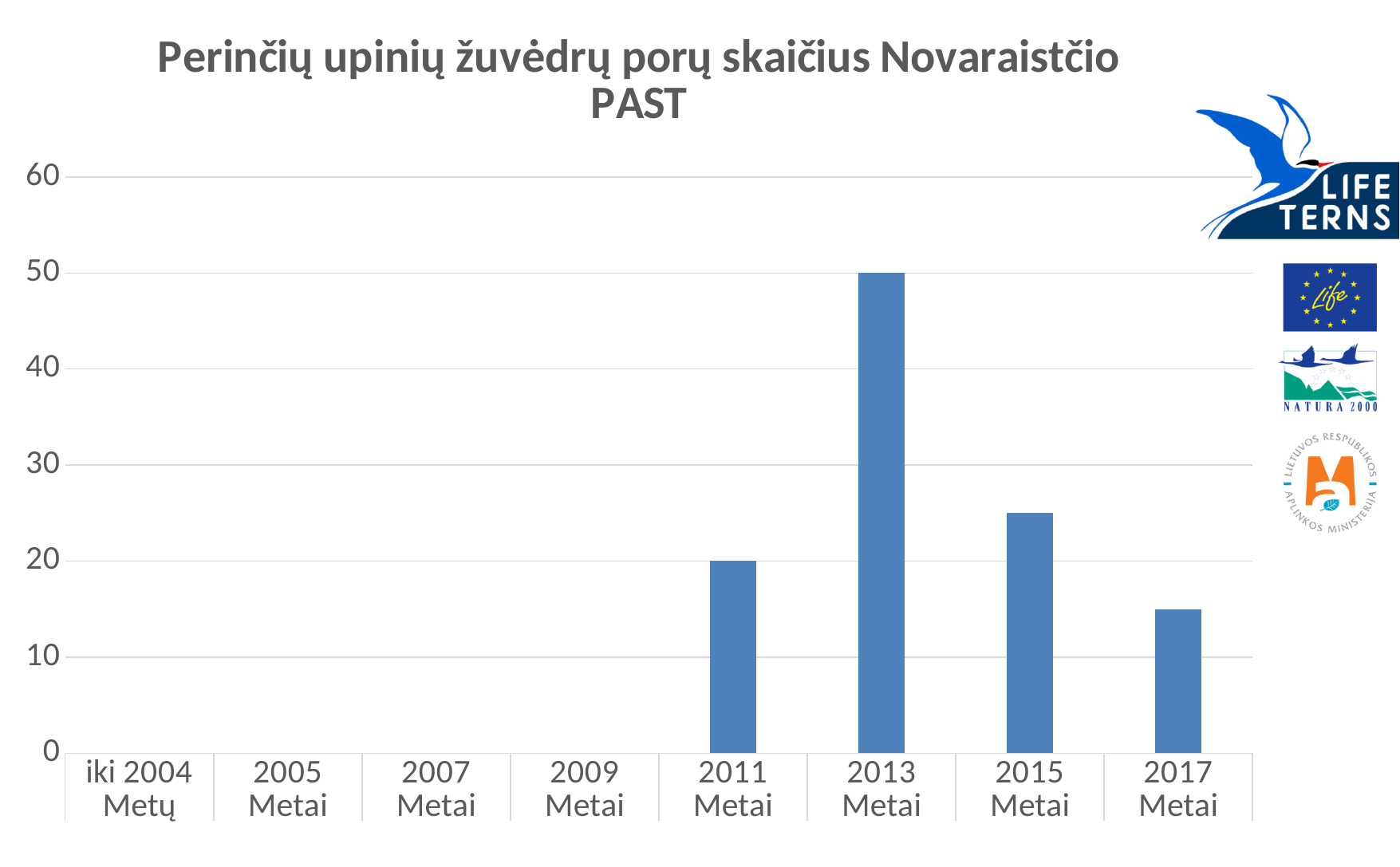
What is the difference between the values for 2013 Metai and 2011 Metai? 30 Do the values rise or fall from 2013 Metai to 2017 Metai? fall Which category has the highest value? 2013 Metai How many categories are shown on the x axis? 8 Is the value for 2017 Metai greater or less than 20? less What is the value for 2011 Metai? 20 What kind of chart is shown on the slide? bar chart What is the value for 2013 Metai? 50 Is the value for 2017 Metai greater or less than 10? greater What is the title of the chart? Perinčių upinių žuvėdrų porų skaičius Novaraistčio PAST Is the value for 2015 Metai greater or less than 20? greater Which is larger, the value for 2015 Metai or the value for 2017 Metai? 2015 Metai